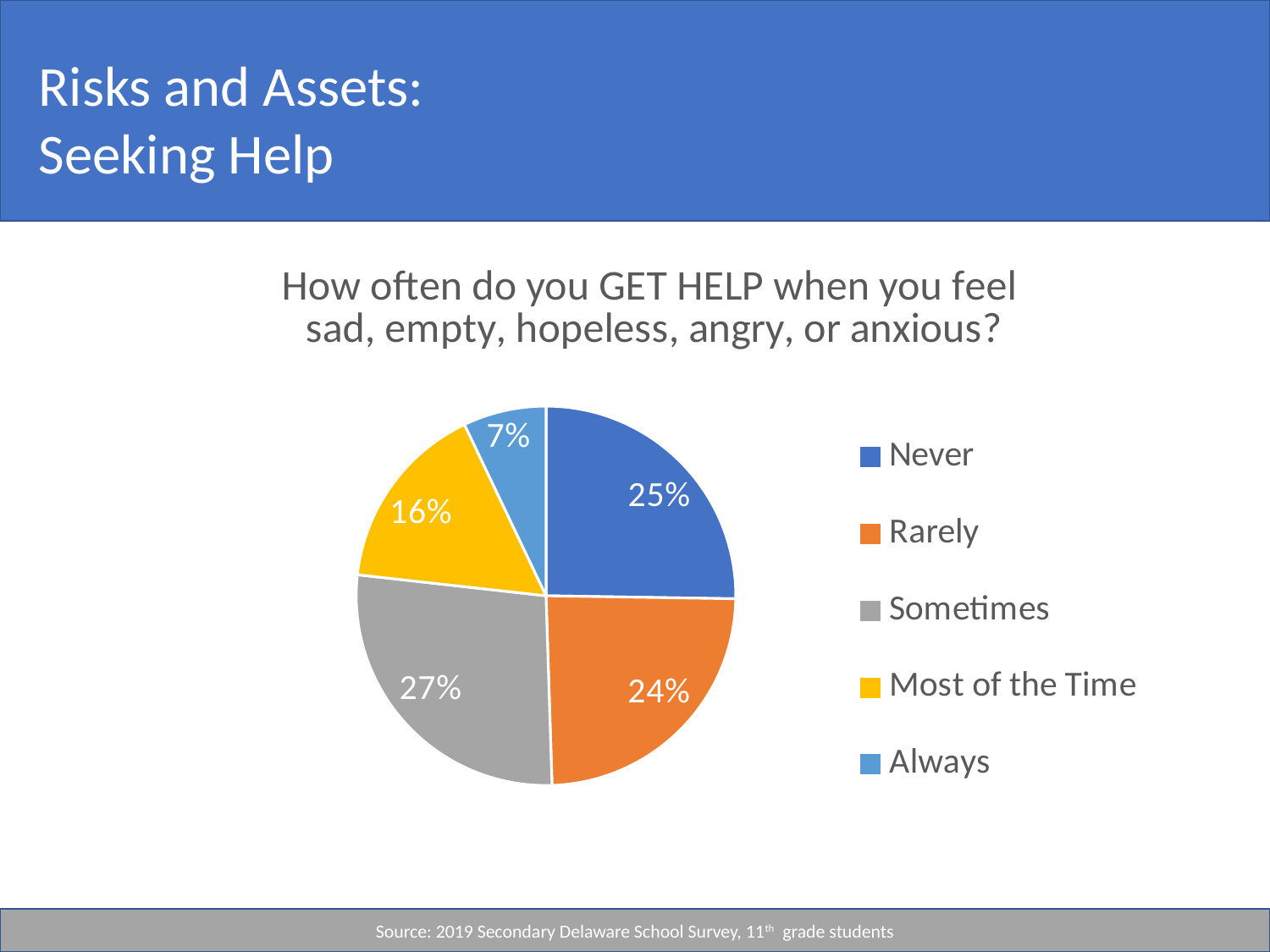
Which is larger, the share for "Never" or the share for "Rarely"? Never What is the difference in percentage points between "Sometimes" and "Always"? 20 What percentage of students answered "Never"? 25% What share of the pie does "Rarely" represent? 24% What percentage of students answered "Always"? 7% What kind of chart is shown on the slide? Pie chart What colour represents "Sometimes" in the pie chart? Gray What is the combined percentage for "Most of the Time" and "Always"? 23% Which response has the largest share of the pie? Sometimes What percentage of students answered "Most of the Time"? 16% Which response has the smallest share of the pie? Always How many response categories does the pie chart show? 5